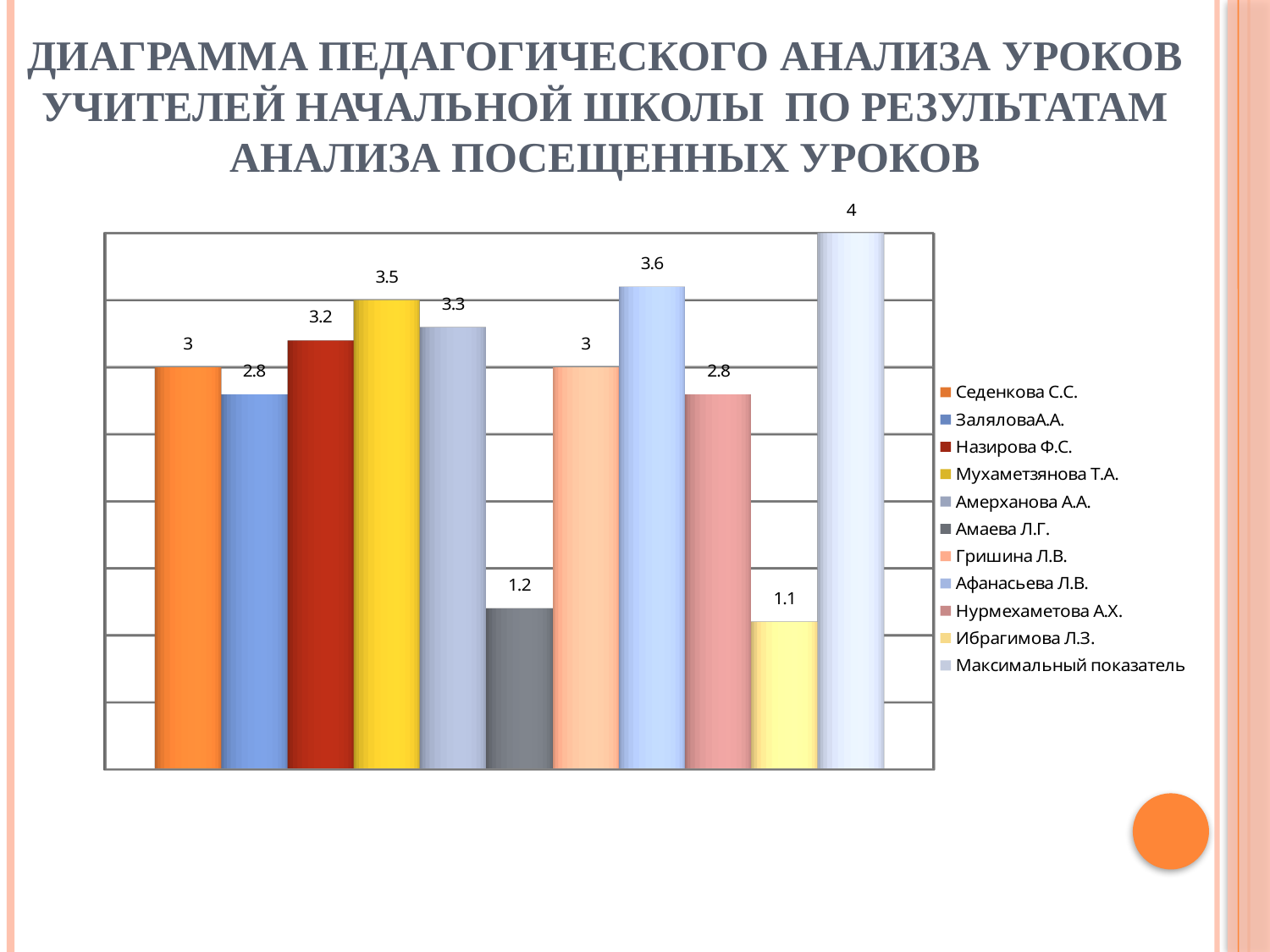
Which is larger, the value for Амерханова А.А. or the value for Нурмехаметова А.Х.? Амерханова А.А. What kind of chart is shown on the slide? Bar chart What value is shown for Афанасьева Л.В.? 3.6 How many entries does the legend list? 11 What value is shown for Амаева Л.Г.? 1.2 Which teacher has the lowest value on the chart? Ибрагимова Л.З. What value is shown for Мухаметзянова Т.А.? 3.5 What colour is the bar for Мухаметзянова Т.А.? Yellow What value is shown for Седенкова С.С.? 3 What is the value of the Максимальный показатель bar? 4 What is the difference between the Максимальный показатель value and the value for Назирова Ф.С.? 0.8 Excluding the Максимальный показатель bar, which teacher has the highest value? Афанасьева Л.В.